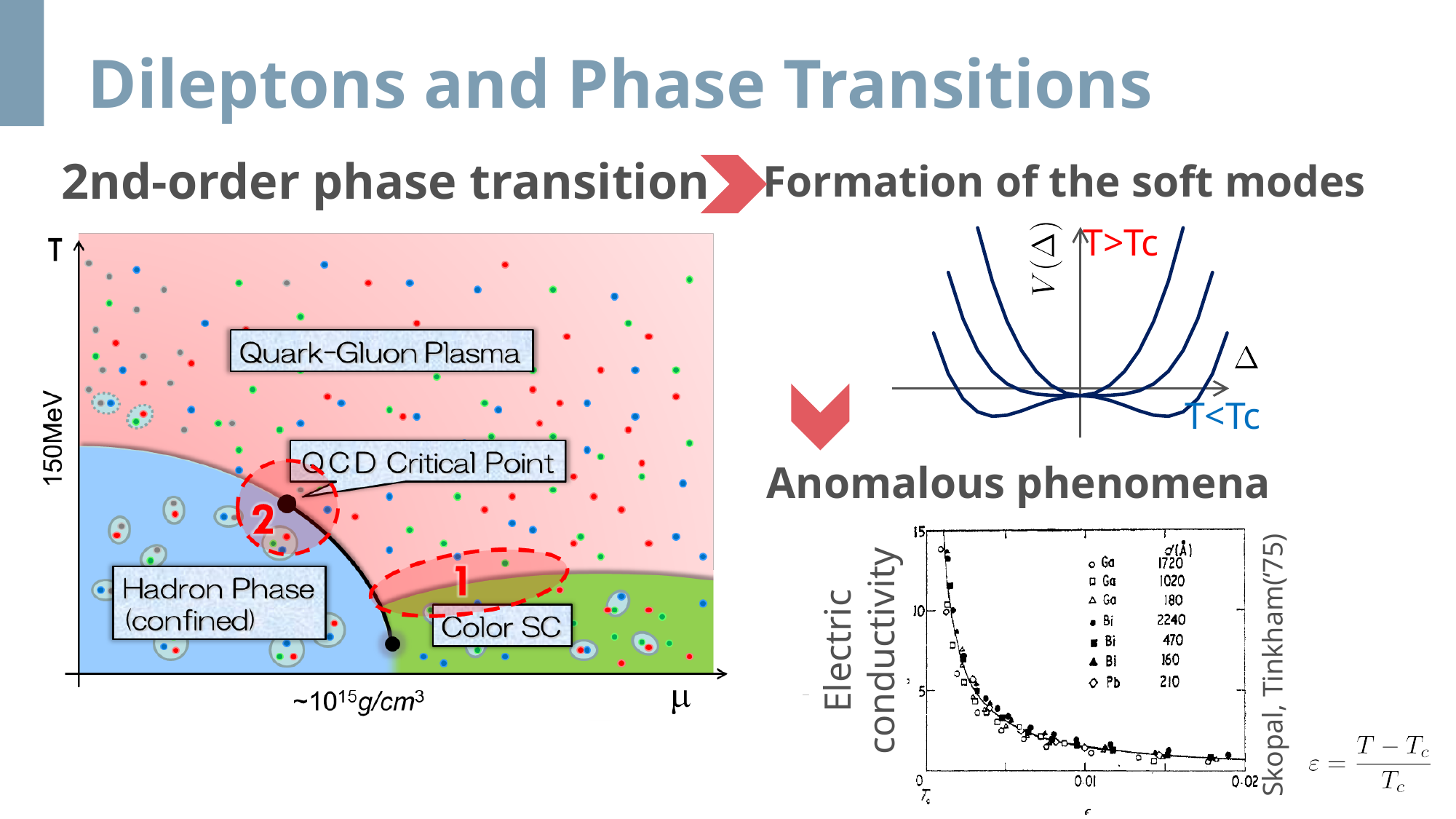
On the phase diagram on the left, how many phases are labeled? 3 On the electric conductivity plot at the bottom right, is the conductivity at ε = 0.01 greater or less than 5? less On the electric conductivity plot at the bottom right, what d(Å) value is listed for Pb in the legend? 210 On the phase diagram on the left, which phase is labeled in the high-temperature region? Quark-Gluon Plasma On the electric conductivity plot at the bottom right, which legend entry has the smallest d(Å) value? Bi 160 On the electric conductivity plot at the bottom right, which legend entry has the largest d(Å) value? Bi 2240 On the electric conductivity plot at the bottom right, how many entries does the legend list? 7 On the electric conductivity plot at the bottom right, what d(Å) value is listed for the first Ga entry in the legend? 1720 On the electric conductivity plot at the bottom right, do the plotted values rise or fall as ε increases? fall On the electric conductivity plot at the bottom right, what is the largest tick value shown on the x axis? 0.02 On the phase diagram on the left, what temperature value is marked on the T axis? 150MeV On the electric conductivity plot at the bottom right, what is the highest tick value shown on the y axis? 15